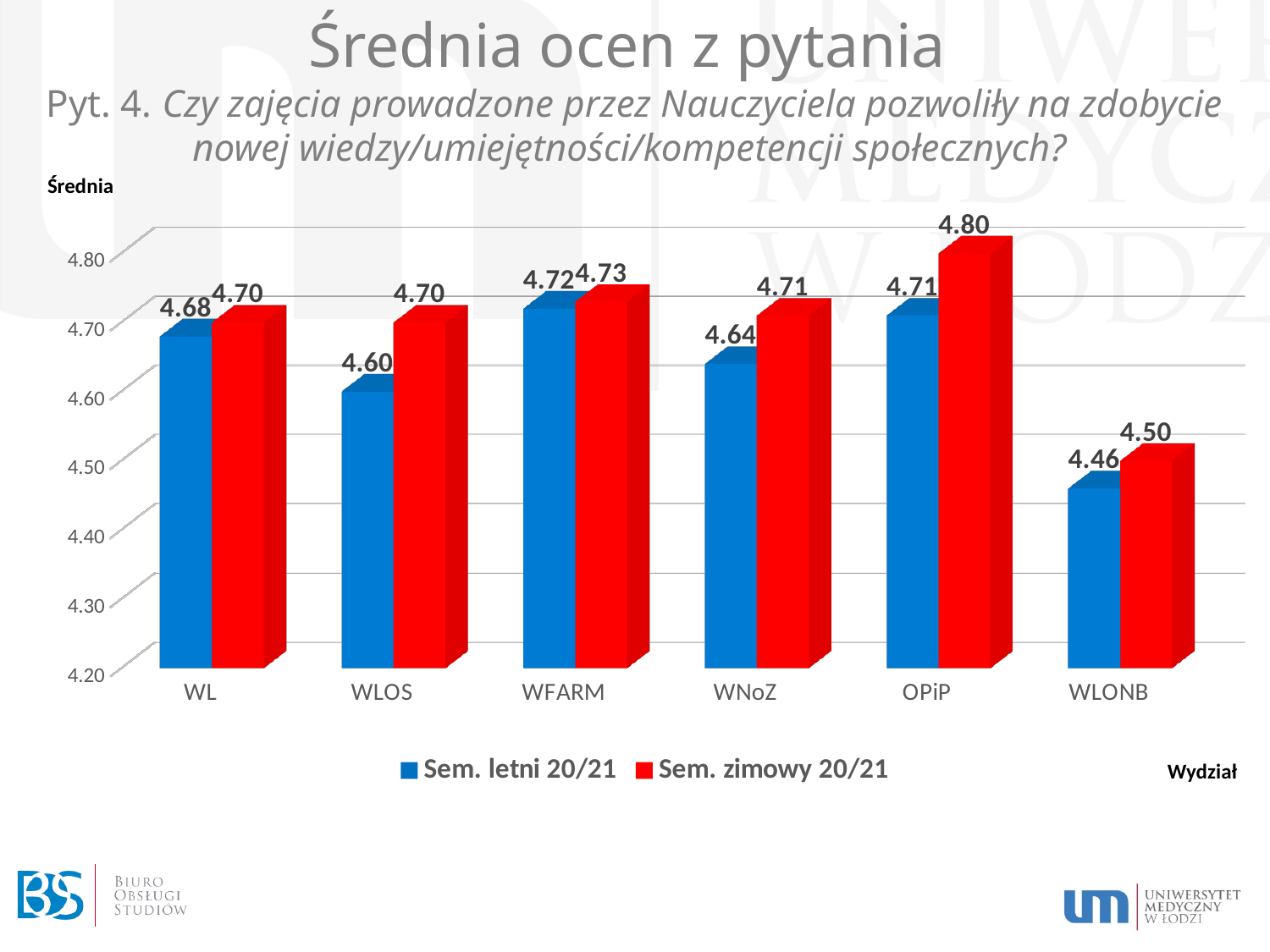
What is the value for WLOS in the Sem. letni 20/21 series? 4.60 Which category has the highest value in the Sem. zimowy 20/21 series? OPiP What is the value for OPiP in the Sem. zimowy 20/21 series? 4.80 Is the Sem. letni 20/21 value for WLONB greater or less than 4.50? less What kind of chart is shown on the slide? bar chart How many series does the legend list? 2 What is the value for WNoZ in the Sem. letni 20/21 series? 4.64 Which is larger for WNoZ: the Sem. letni 20/21 value or the Sem. zimowy 20/21 value? Sem. zimowy 20/21 How many categories are shown on the x axis? 6 Which category has the lowest value in the Sem. letni 20/21 series? WLONB What is the difference between the Sem. zimowy 20/21 and Sem. letni 20/21 values for WLOS? 0.10 What is the difference between the Sem. zimowy 20/21 and Sem. letni 20/21 values for OPiP? 0.09